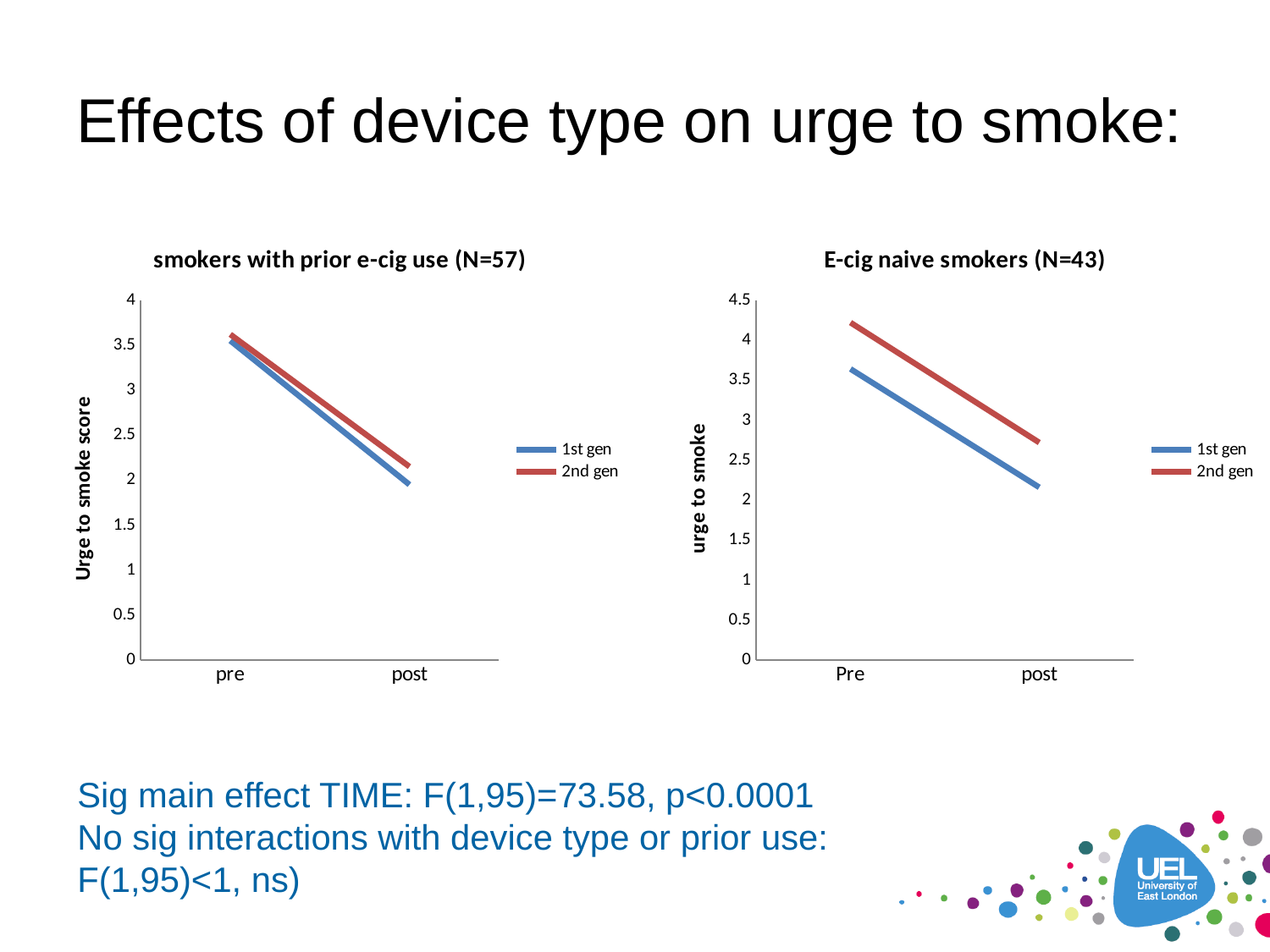
In the 'smokers with prior e-cig use (N=57)' chart, is the 1st gen value at pre greater or less than 3? greater What is the y-axis label of the 'smokers with prior e-cig use (N=57)' chart? Urge to smoke score In the 'E-cig naive smokers (N=43)' chart, is the 2nd gen value at post greater or less than 3? less In the 'smokers with prior e-cig use (N=57)' chart, how many points are on the x axis? 2 In the 'E-cig naive smokers (N=43)' chart, which series has the higher value at Pre, 1st gen or 2nd gen? 2nd gen In the 'smokers with prior e-cig use (N=57)' chart, does the 2nd gen line rise or fall from pre to post? fall In the 'E-cig naive smokers (N=43)' chart, is the 2nd gen value at Pre greater or less than 4? greater In the 'E-cig naive smokers (N=43)' chart, which series has the higher value at post, 1st gen or 2nd gen? 2nd gen In the 'E-cig naive smokers (N=43)' chart, does the 1st gen line rise or fall from Pre to post? fall What kind of chart is the 'smokers with prior e-cig use (N=57)' chart? line chart How many series does the legend of the 'E-cig naive smokers (N=43)' chart list? 2